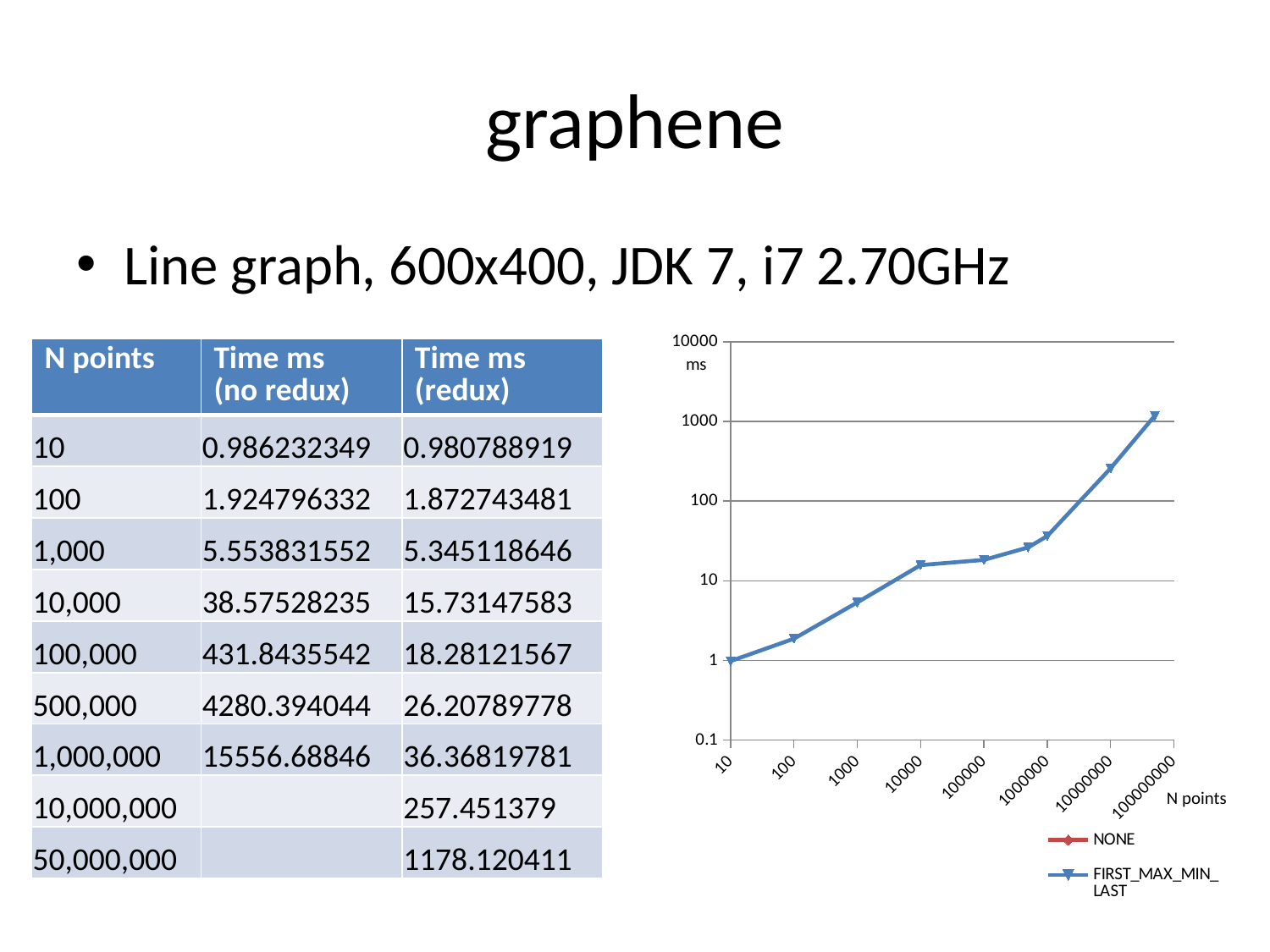
How many series does the chart legend list? 2 Is the value for 1000 N points greater or less than 10 ms? less Is the value for 1000000 N points greater or less than 100 ms? less Is the value for 100 N points greater or less than 1 ms? greater Do the plotted values rise or fall as N points increases along the x axis? rise What is the label on the chart's x axis? N points Which is larger, the value at 100000 N points or the value at 10000000 N points? 10000000 N points What are the names of the series listed in the chart legend? NONE and FIRST_MAX_MIN_LAST What kind of chart is shown on the slide? line chart How many data points are plotted on the FIRST_MAX_MIN_LAST line? 9